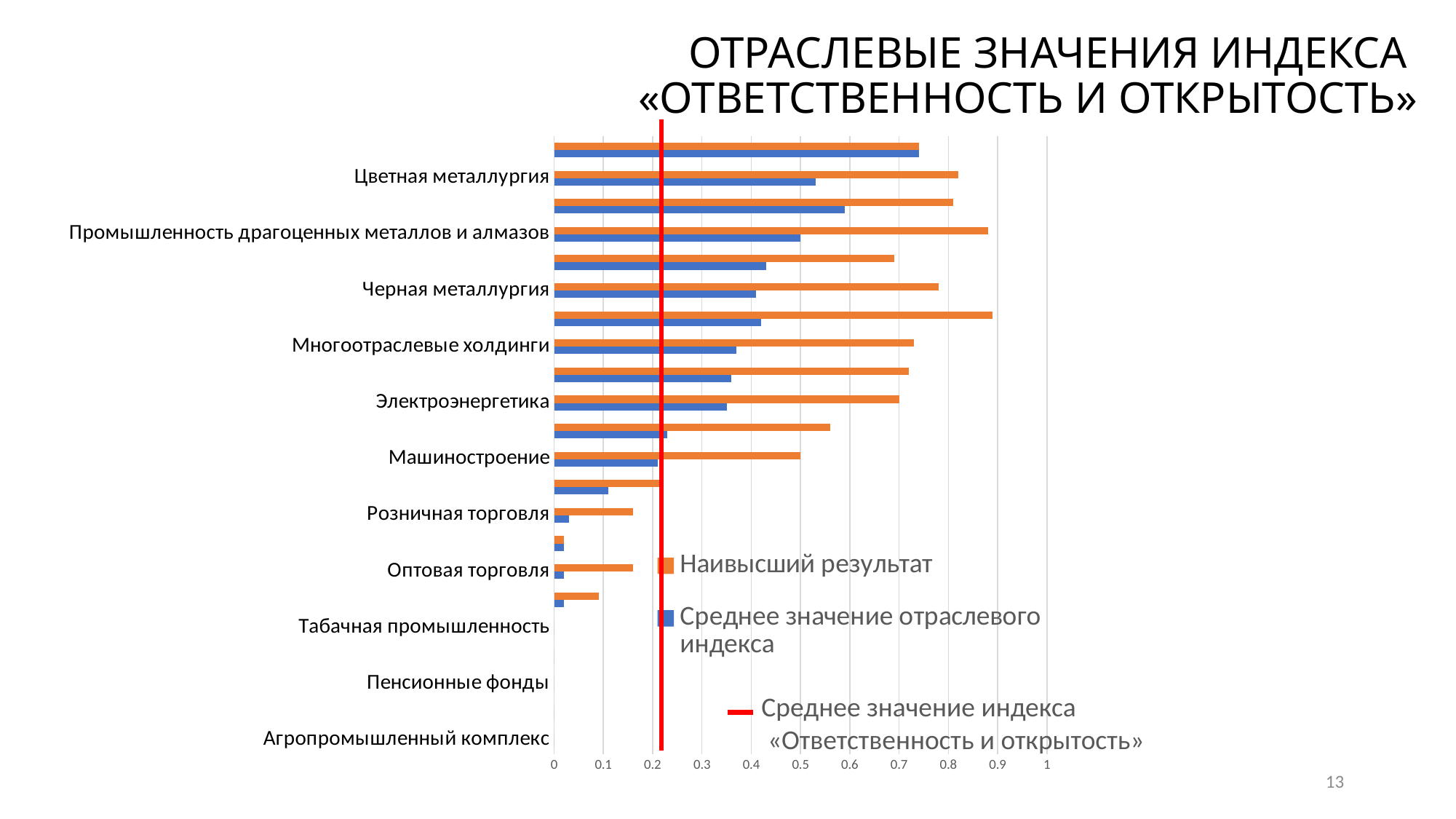
Is the «Наивысший результат» value for Черная металлургия greater or less than 0.7? greater Is the «Среднее значение отраслевого индекса» value for Электроэнергетика greater or less than 0.4? less How many entries does the chart legend list? 3 Is the «Наивысший результат» value for Оптовая торговля greater or less than 0.2? less What does the red vertical line on the chart represent? Среднее значение индекса «Ответственность и открытость» What type of chart is shown on the slide? Bar chart Which colour represents the series «Наивысший результат»? Orange For Цветная металлургия, which is larger: «Наивысший результат» or «Среднее значение отраслевого индекса»? Наивысший результат